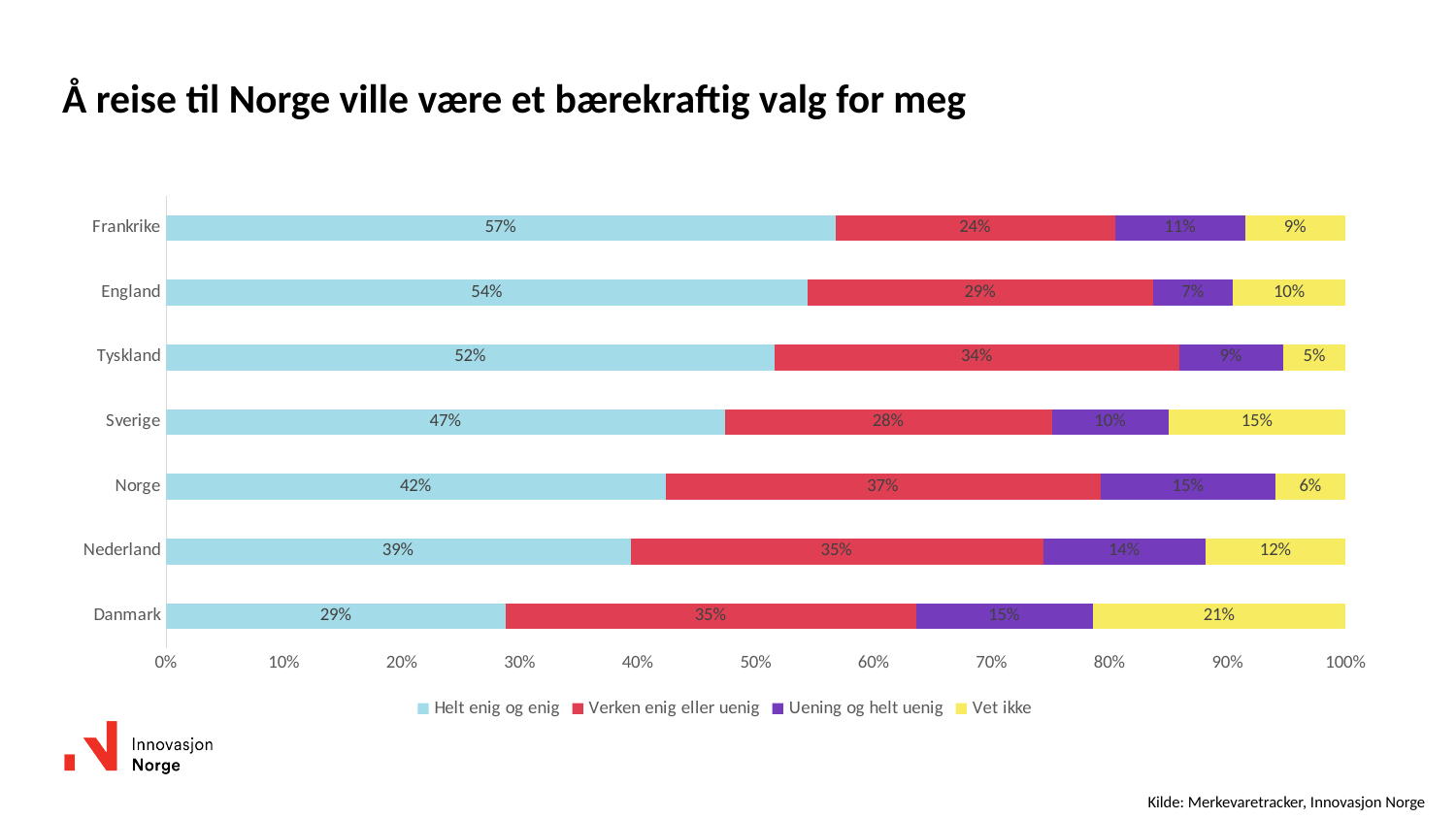
Which country has the lowest "Helt enig og enig" share? Danmark Which country has the highest "Helt enig og enig" share? Frankrike What is the "Vet ikke" value for Danmark? 21% What is the total of the "Helt enig og enig" and "Verken enig eller uenig" segments for Tyskland? 86% What percentage of respondents in Frankrike answered "Helt enig og enig"? 57% Which is larger: the "Vet ikke" value for Sverige or for Tyskland? Sverige What is the "Verken enig eller uenig" value for Norge? 37% How many countries are shown on the chart? 7 What is the difference between the "Helt enig og enig" values for England and Nederland? 15% What is the title of the chart? Å reise til Norge ville være et bærekraftig valg for meg What kind of chart is shown on the slide? Stacked bar chart How many series does the legend list? 4